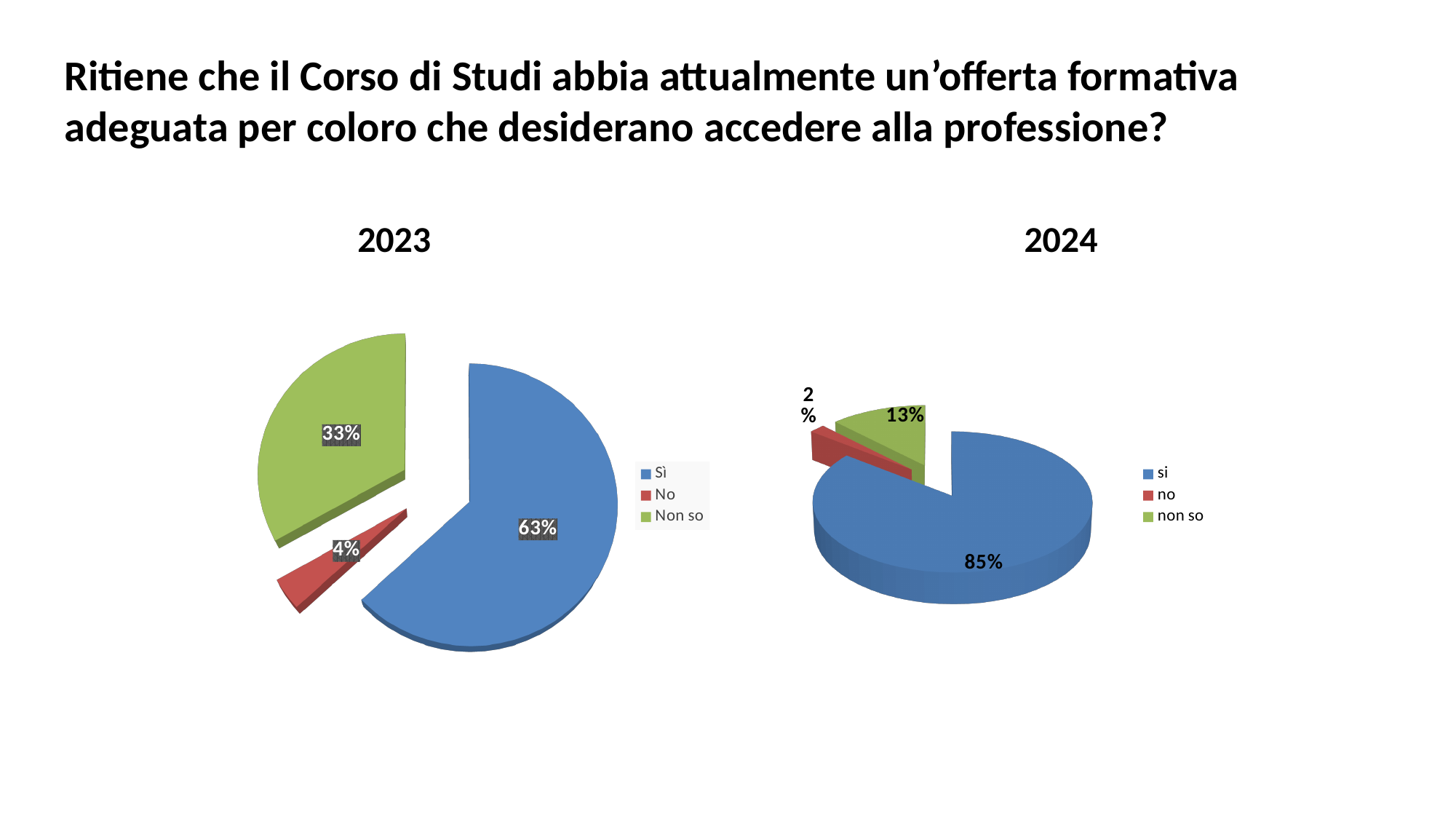
What type of chart is used for the 2023 data? Pie chart In the 2024 chart, what share of respondents answered "no"? 2% In the 2024 chart, what share of respondents answered "non so"? 13% Which is larger: the "Non so" share in the 2023 chart or the "non so" share in the 2024 chart? 2023 (33%) In the 2024 chart, which answer has the smallest slice? no How many entries does the legend of the 2024 chart list? 3 In the 2023 chart, which answer has the largest slice? Sì In the 2023 chart, what share of respondents answered "No"? 4% In the 2023 chart, what share of respondents answered "Non so"? 33% In the 2023 chart, what share of respondents answered "Sì"? 63% In the 2024 chart, what share of respondents answered "si"? 85% What is the difference between the "Sì" share in the 2023 chart and the "si" share in the 2024 chart? 22 percentage points